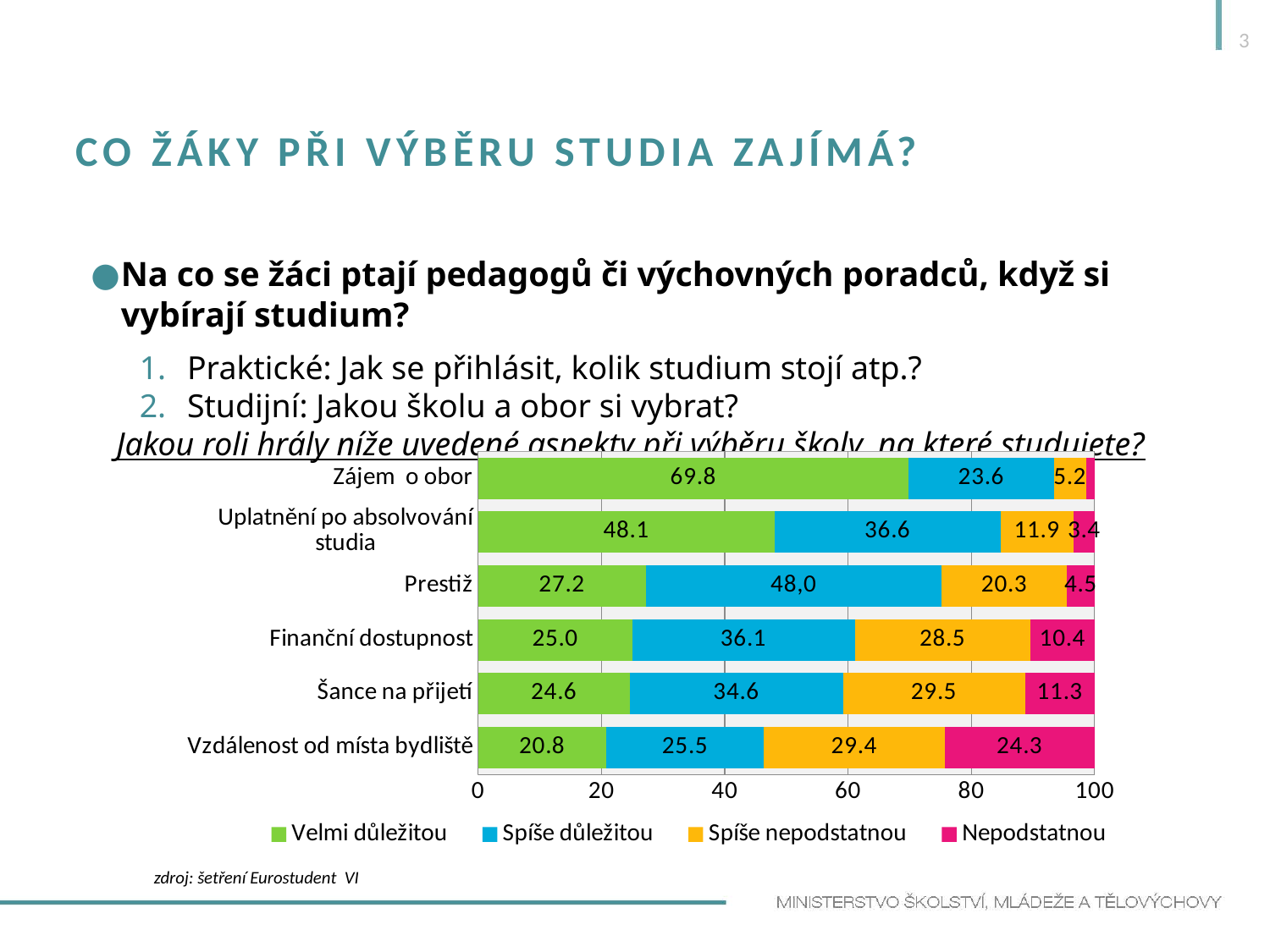
What kind of chart is shown on the slide? stacked bar chart Which category has the lowest 'Velmi důležitou' value? Vzdálenost od místa bydliště Which is larger: the 'Nepodstatnou' value for 'Finanční dostupnost' or for 'Šance na přijetí'? Šance na přijetí Which category has the highest 'Velmi důležitou' value? Zájem o obor How many series does the legend list? 4 What is the difference between the 'Velmi důležitou' values for 'Zájem o obor' and 'Uplatnění po absolvování studia'? 21.7 How many categories are plotted on the chart? 6 What is the 'Velmi důležitou' value for 'Zájem o obor'? 69.8 Which series is shown in green in the legend? Velmi důležitou What is the 'Spíše nepodstatnou' value for 'Šance na přijetí'? 29.5 What is the 'Spíše důležitou' value for 'Prestiž'? 48,0 What is the 'Nepodstatnou' value for 'Vzdálenost od místa bydliště'? 24.3